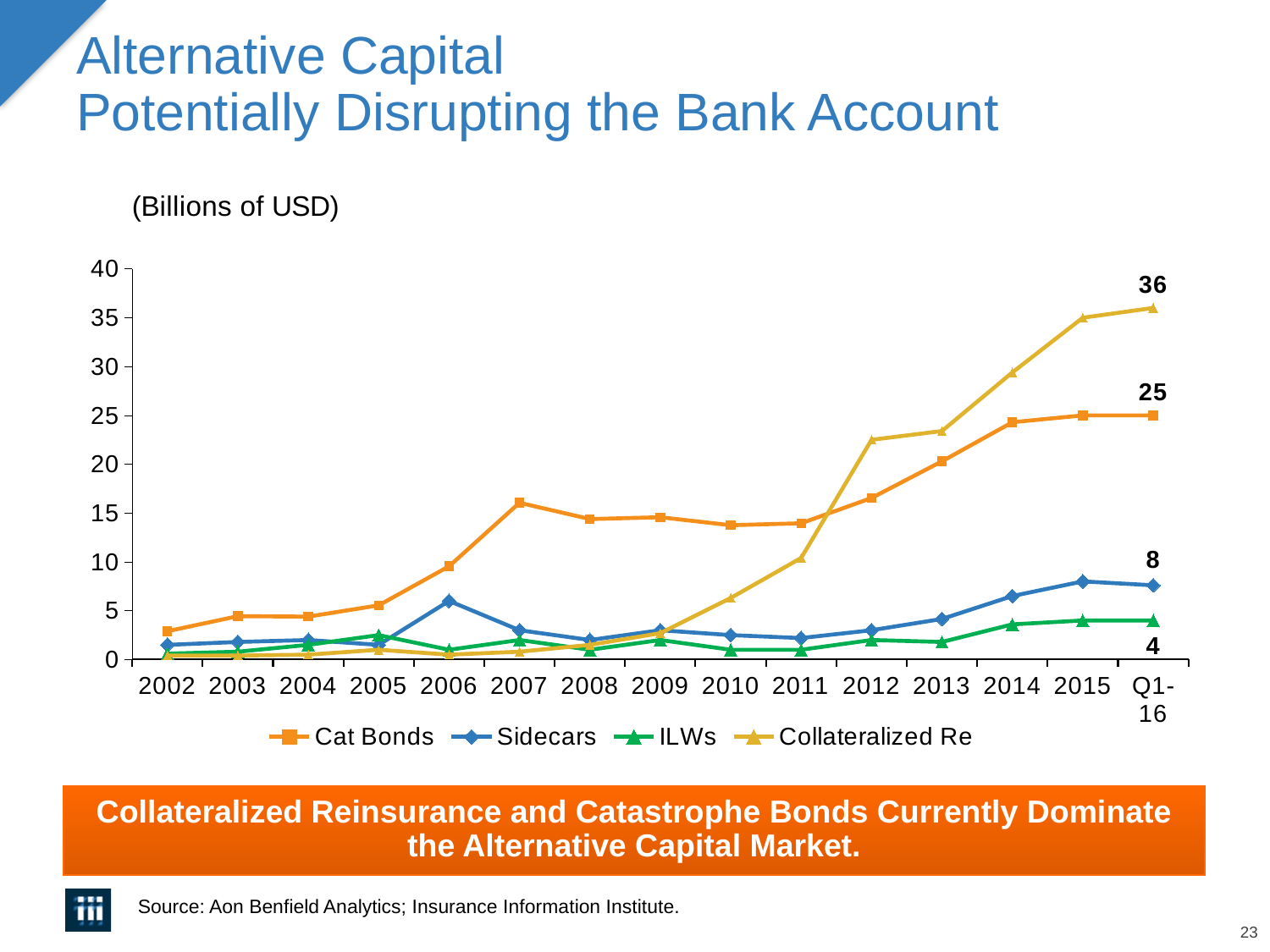
What is the value for Sidecars at Q1-16? 8 What is the value for Collateralized Re at Q1-16? 36 What is the difference between the Collateralized Re and Cat Bonds values at Q1-16? 11 What type of chart is shown on the slide? line chart How many points are plotted along the x axis for each series? 15 Does the Collateralized Re series generally rise or fall from 2010 to 2015? rise What is the value for ILWs at Q1-16? 4 Which series has the highest value at Q1-16? Collateralized Re Is the value for Cat Bonds in 2007 greater or less than 10? greater Which series has the lowest value at Q1-16? ILWs What is the value for Cat Bonds at Q1-16? 25 How many series does the legend list? 4